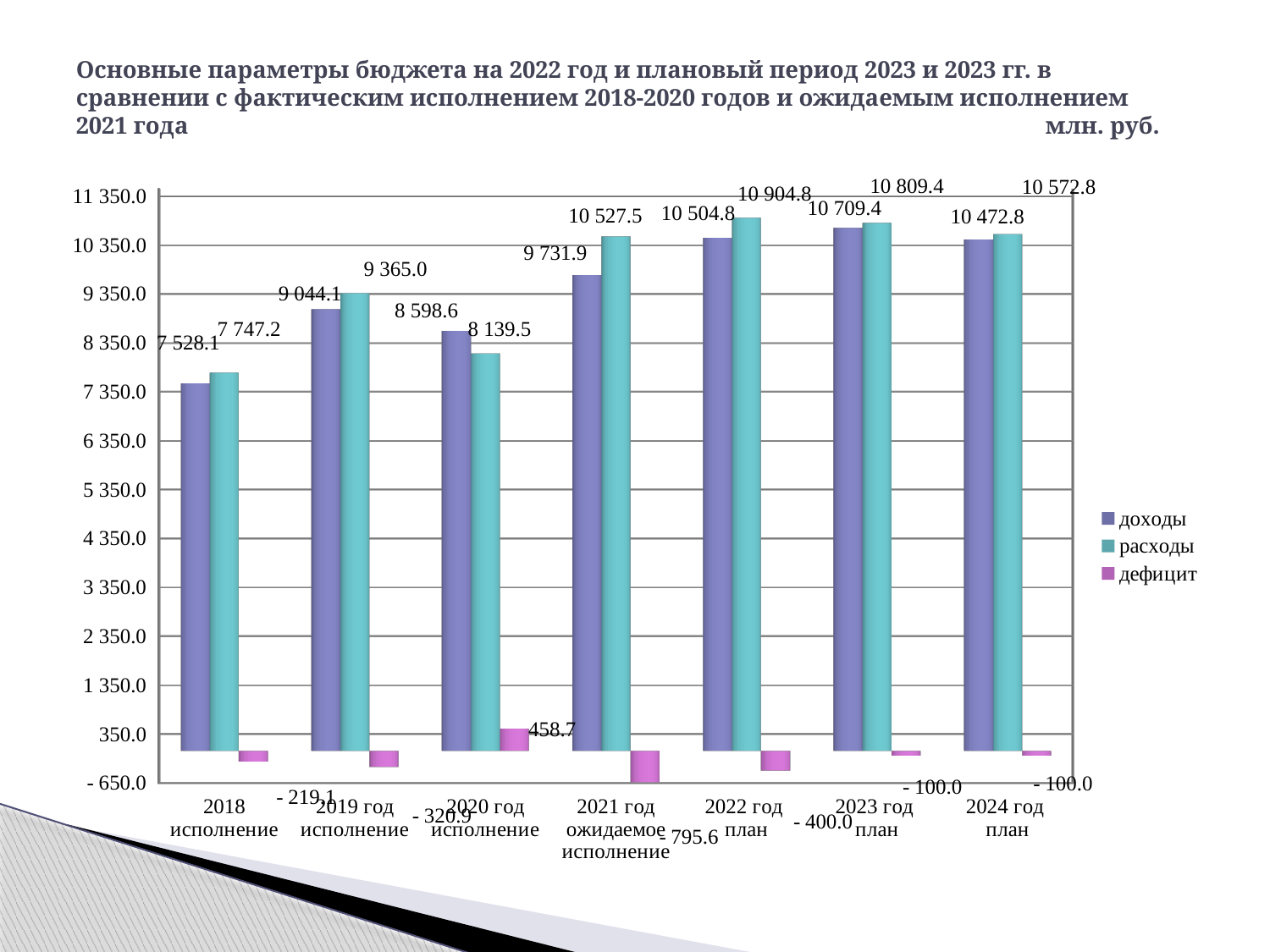
For 2020 год исполнение, which is larger: доходы or расходы? доходы What is the value of доходы for 2019 год исполнение? 9 044.1 How many series does the legend list? 3 What kind of chart is shown on the slide? bar chart How many categories are shown on the x axis? 7 Is the value of доходы for 2023 год план greater or less than 10 350.0? greater What is the value of расходы for 2021 год ожидаемое исполнение? 10 527.5 Which category has the lowest value of доходы? 2018 исполнение What is the difference between расходы and доходы for 2022 год план? 400.0 What unit of measurement is stated at the top right of the slide? млн. руб. What is the value of дефицит for 2020 год исполнение? 458.7 Which category has the highest value of расходы? 2022 год план